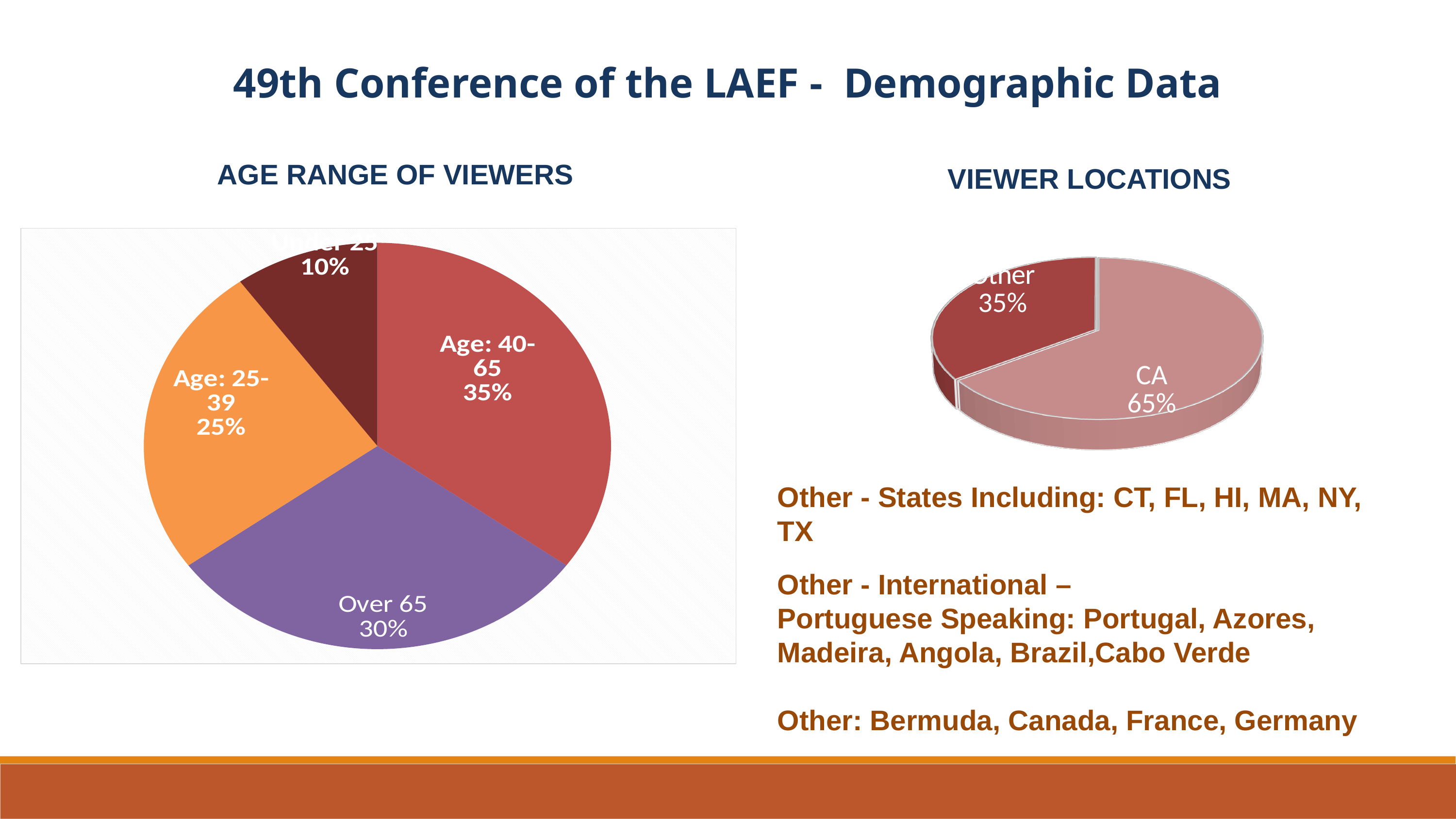
In the Age Range of Viewers chart, what share of viewers are Age 25-39? 25% In the Age Range of Viewers chart, what share of viewers are Over 65? 30% In the Age Range of Viewers chart, which is larger: the Over 65 slice or the Age 25-39 slice? Over 65 In the Age Range of Viewers chart, which age group has the largest share? Age 40-65 In the Viewer Locations chart, what share of viewers are from Other locations? 35% In the Age Range of Viewers chart, what is the difference in percentage points between the Age 40-65 and Age 25-39 slices? 10 In the Viewer Locations chart, what share of viewers are from CA? 65% In the Age Range of Viewers chart, which age group has the smallest share? Under 25 In the Age Range of Viewers chart, how many age groups are shown? 4 In the Age Range of Viewers chart, what share of viewers are Age 40-65? 35% What type of chart is the Viewer Locations chart? Pie chart In the Viewer Locations chart, how many slices are there? 2